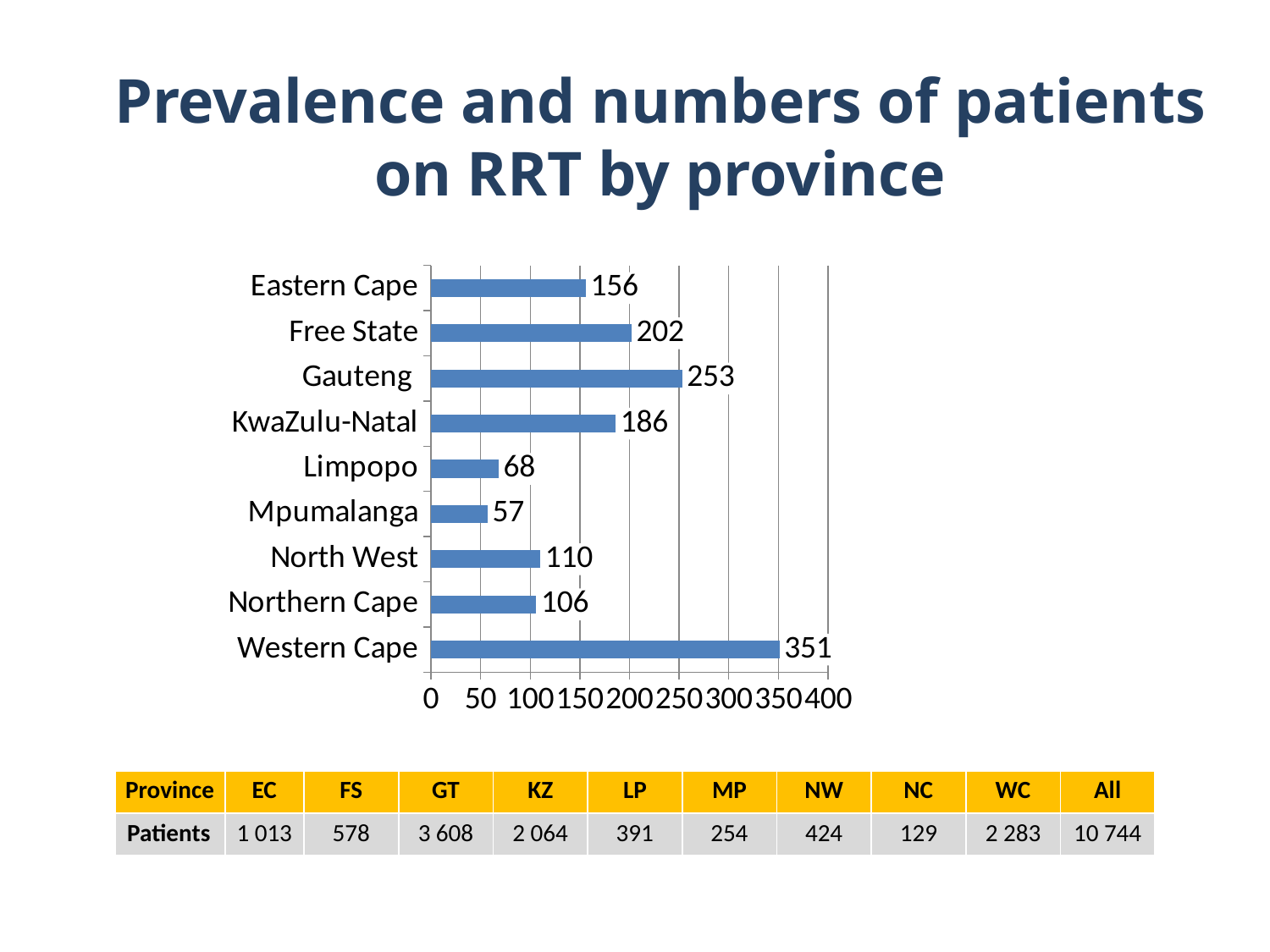
What is the title of the slide containing the chart? Prevalence and numbers of patients on RRT by province Which has a larger value in the bar chart, Limpopo or Eastern Cape? Eastern Cape What is the difference between the values for Free State and Eastern Cape in the bar chart? 46 What kind of chart is shown on the slide? Bar chart What is the value shown for KwaZulu-Natal in the bar chart? 186 Which province has the lowest value in the bar chart? Mpumalanga Which province has the highest value in the bar chart? Western Cape What is the value shown for Gauteng in the bar chart? 253 How many provinces are shown in the bar chart? 9 What is the value shown for Mpumalanga in the bar chart? 57 Which has a larger value in the bar chart, North West or Northern Cape? North West What is the difference between the values for Western Cape and Gauteng in the bar chart? 98